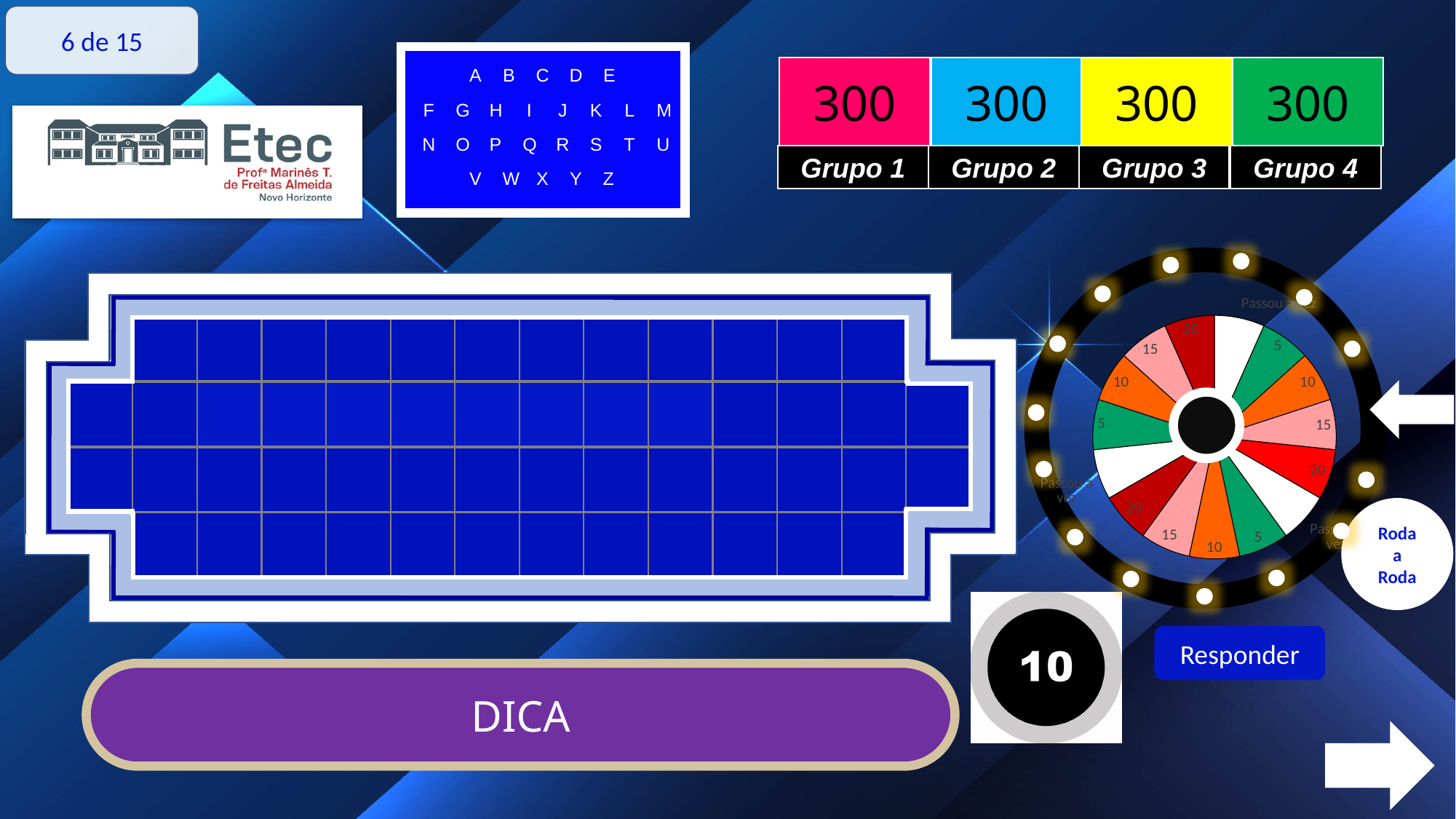
What kind of chart is the wheel on the right side of the slide? pie chart What is the difference between the largest and smallest numbers printed on the wheel? 15 What colour are the wheel segments labelled 20? red Which is larger, the value on a red segment of the wheel or the value on a green segment? red segment What colour are the wheel segments labelled 5? green What is the lowest number printed on any segment of the wheel? 5 What is the highest number printed on any segment of the wheel? 20